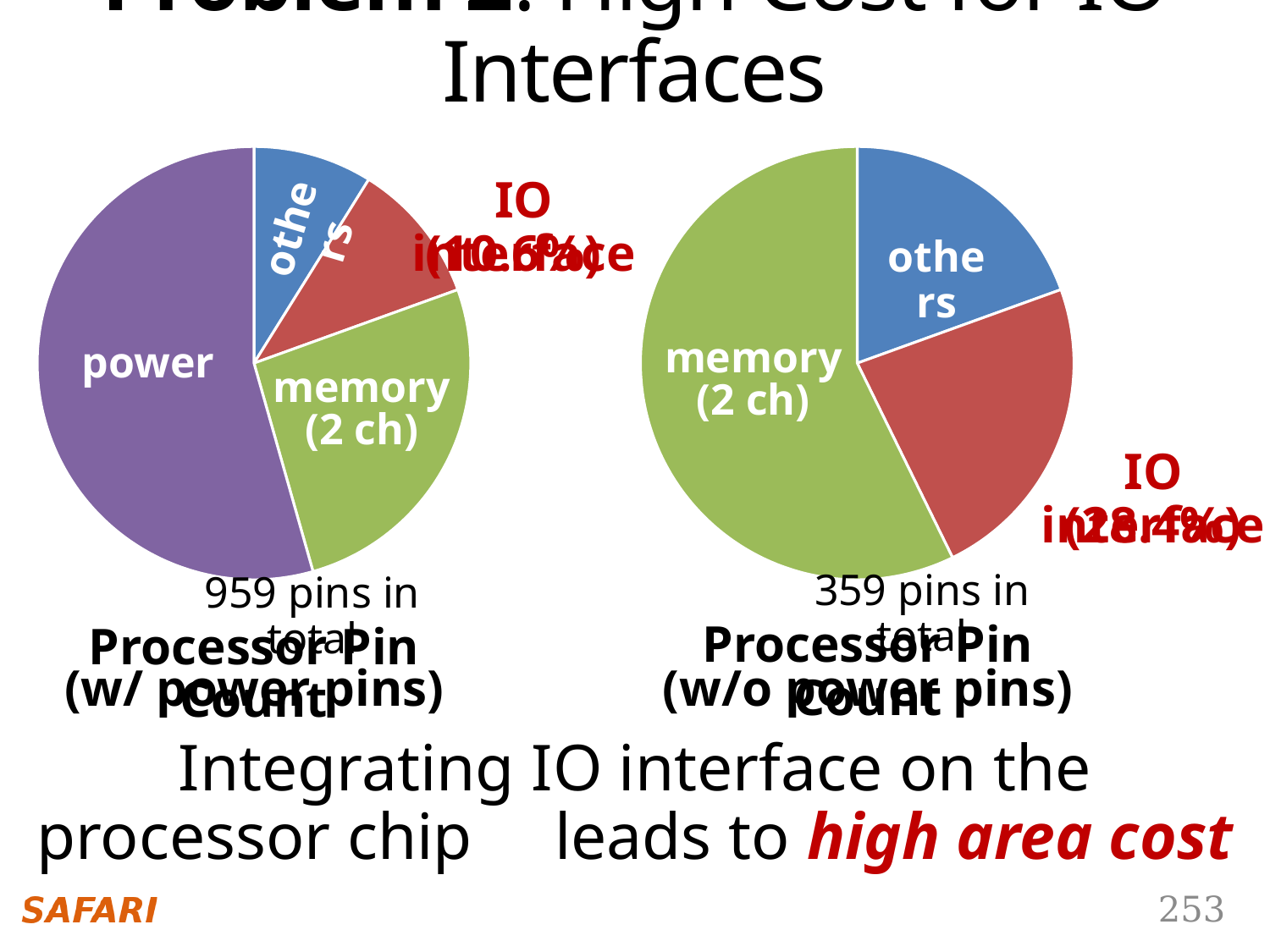
In the left pie chart (with power pins), which slice is larger: power or memory (2 ch)? power How many slices does the left pie chart (with power pins) have? 4 In the right pie chart (without power pins), which slice is larger: memory (2 ch) or IO interface? memory (2 ch) In the right pie chart (without power pins), which category has the smallest slice? others What kind of charts are shown on the slide? Pie charts What is the difference between the total pin counts of the left chart (959 pins) and the right chart (359 pins)? 600 pins What colour is the memory (2 ch) slice in both pie charts? Green How many pins in total does the right pie chart (without power pins) represent? 359 pins In the left pie chart (with power pins), which category has the largest slice? power How many slices does the right pie chart (without power pins) have? 3 In the right pie chart (without power pins), which category has the largest slice? memory (2 ch) How many pins in total does the left pie chart (with power pins) represent? 959 pins